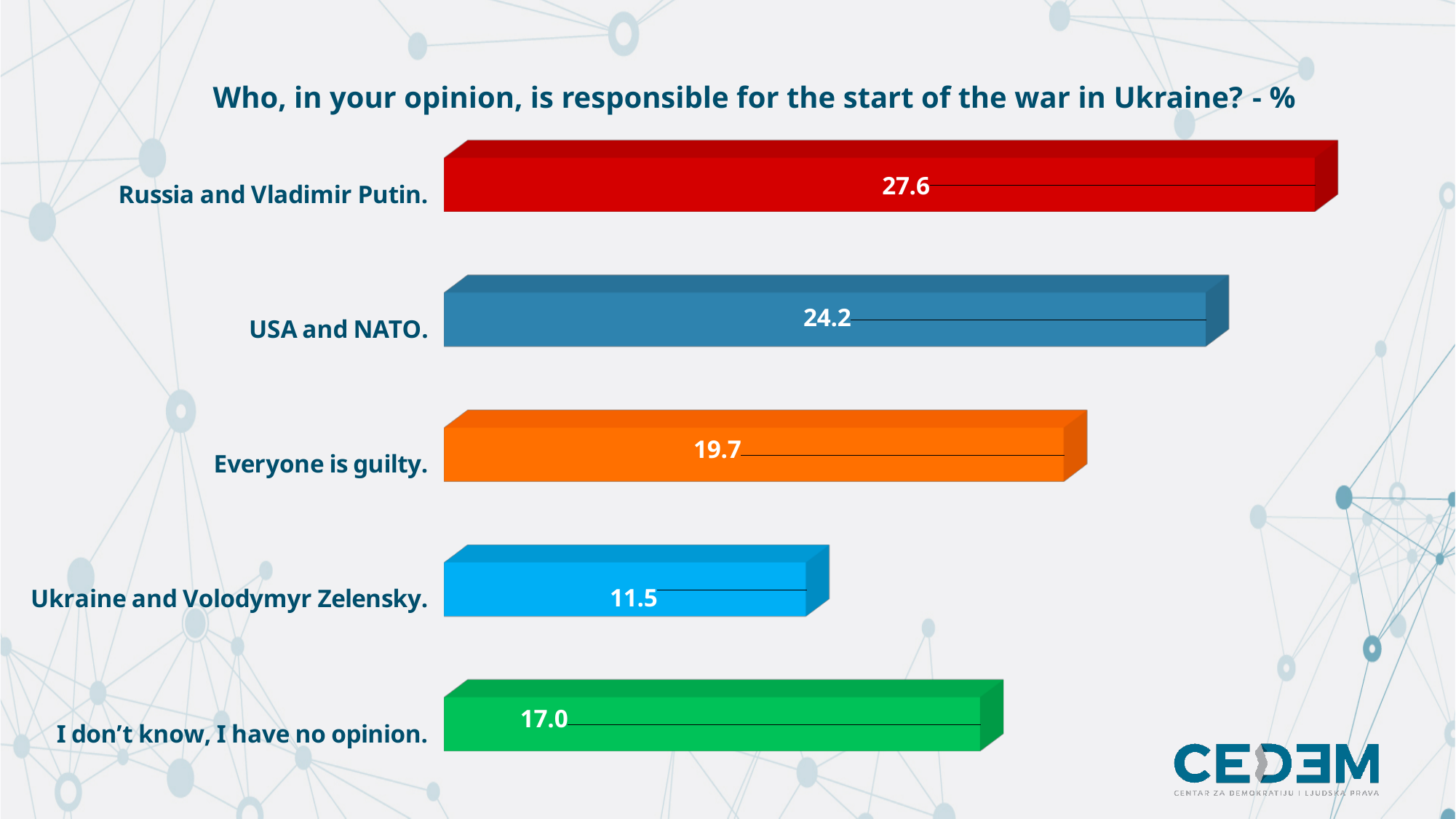
How many categories are shown in the chart? 5 What is the difference between the values for "Russia and Vladimir Putin." and "USA and NATO."? 3.4 What kind of chart is shown on the slide? Bar chart Which is larger, the value for "Everyone is guilty." or the value for "I don't know, I have no opinion."? Everyone is guilty. Which category has the highest value? Russia and Vladimir Putin. What is the value for "USA and NATO."? 24.2 What is the value for "Ukraine and Volodymyr Zelensky."? 11.5 Which category has the lowest value? Ukraine and Volodymyr Zelensky. What is the value for "Russia and Vladimir Putin."? 27.6 What is the title of the chart? Who, in your opinion, is responsible for the start of the war in Ukraine? - % What is the value for "I don't know, I have no opinion."? 17.0 What is the value for "Everyone is guilty."? 19.7